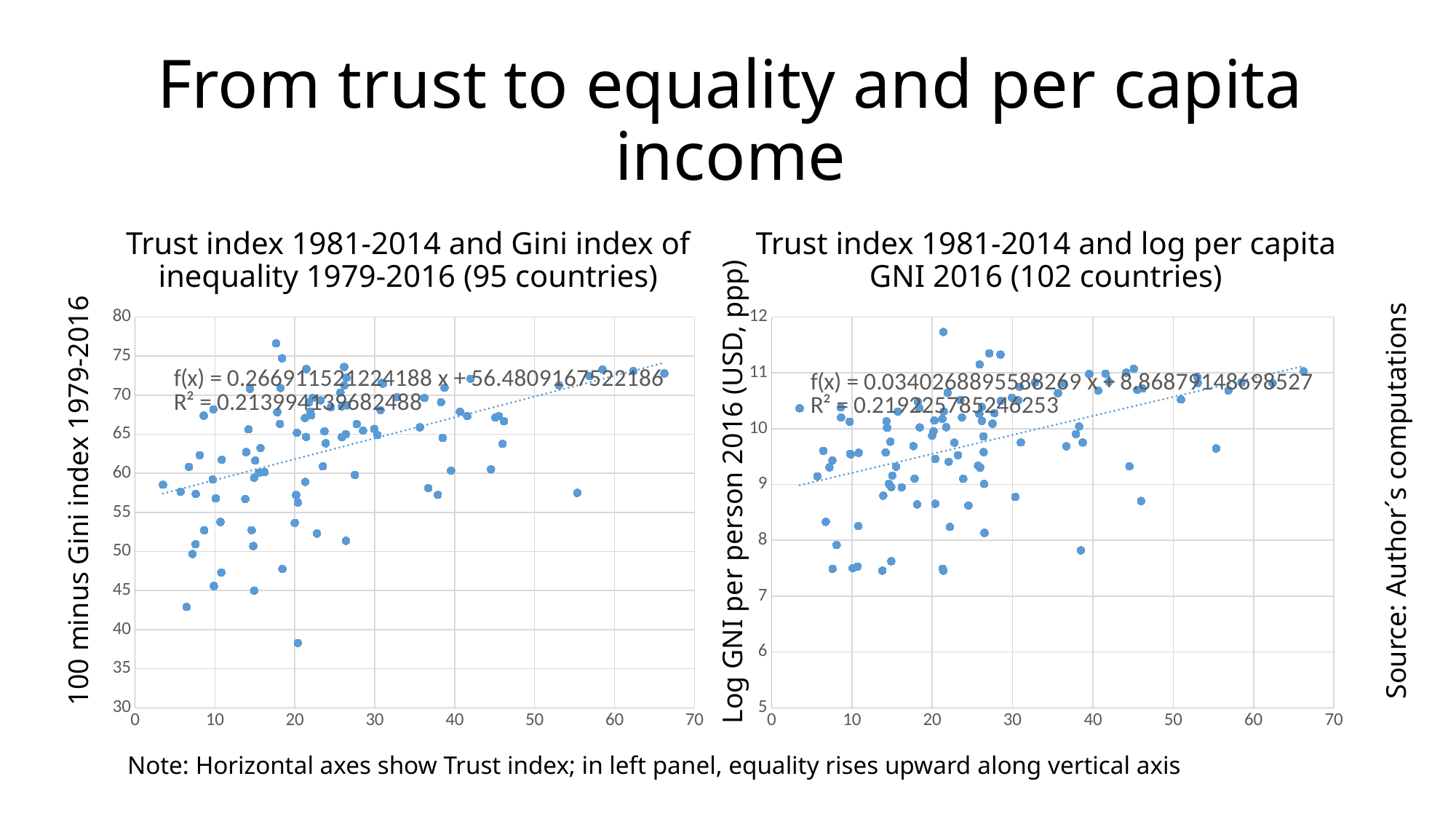
What is the fitted equation printed on the right chart, 'Trust index 1981-2014 and log per capita GNI 2016'? f(x) = 0.0340268895588269 x + 8.86879148698527 In the right chart, 'Trust index 1981-2014 and log per capita GNI 2016', is the highest plotted point greater or less than 11 on the vertical axis? greater What is the R² value printed on the right chart, 'Trust index 1981-2014 and log per capita GNI 2016'? 0.219225785246253 What is the R² value printed on the left chart, 'Trust index 1981-2014 and Gini index of inequality 1979-2016'? 0.213994139682488 According to its title, how many countries are plotted in the left chart, 'Trust index 1981-2014 and Gini index of inequality 1979-2016'? 95 What is the vertical axis label of the right chart, 'Trust index 1981-2014 and log per capita GNI 2016'? Log GNI per person 2016 (USD, ppp) In the right chart, 'Trust index 1981-2014 and log per capita GNI 2016 (102 countries)', does the fitted trend line rise or fall as the Trust index increases? Rises In the left chart, 'Trust index 1981-2014 and Gini index of inequality 1979-2016', is the highest plotted point greater or less than 75 on the vertical axis? greater According to its title, how many countries are plotted in the right chart, 'Trust index 1981-2014 and log per capita GNI 2016'? 102 In the left chart, 'Trust index 1981-2014 and Gini index of inequality 1979-2016', does the fitted trend line rise or fall as the Trust index increases? Rises What kind of chart is the left chart, 'Trust index 1981-2014 and Gini index of inequality 1979-2016 (95 countries)'? Scatter chart Which chart shows the higher R² value, the left chart (Gini index) or the right chart (log per capita GNI)? The right chart (log per capita GNI)